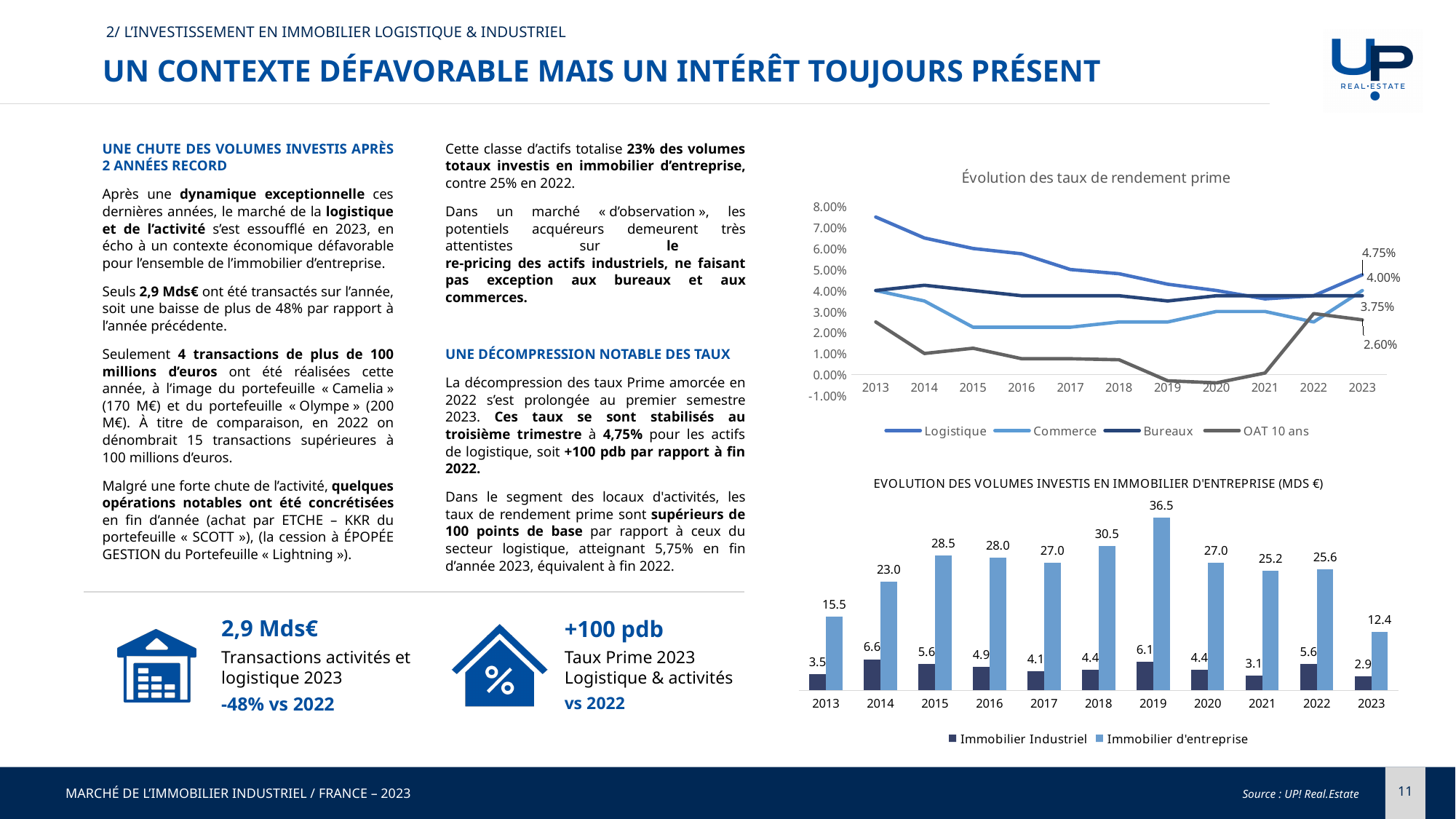
In the chart 'Évolution des taux de rendement prime', does the Logistique series rise or fall between 2013 and 2019? Fall In the bar chart 'Evolution des volumes investis en immobilier d'entreprise', what is the value for Immobilier Industriel in 2023? 2.9 In the chart 'Évolution des taux de rendement prime', is the value for Logistique in 2013 greater or less than 7.00%? greater In the chart 'Évolution des taux de rendement prime', what is the value for OAT 10 ans in 2023? 2.60% How many years are shown on the x axis of the bar chart 'Evolution des volumes investis en immobilier d'entreprise'? 11 In the bar chart 'Evolution des volumes investis en immobilier d'entreprise', what is the value for Immobilier d'entreprise in 2019? 36.5 In the bar chart 'Evolution des volumes investis en immobilier d'entreprise', which year has the lowest value for Immobilier Industriel? 2023 How many series does the legend of the chart 'Évolution des taux de rendement prime' list? 4 In the chart 'Évolution des taux de rendement prime', what is the value for Logistique in 2023? 4.75% In the bar chart 'Evolution des volumes investis en immobilier d'entreprise', which year has the highest value for Immobilier d'entreprise? 2019 What kind of chart is 'Évolution des taux de rendement prime'? Line chart In the bar chart 'Evolution des volumes investis en immobilier d'entreprise', what is the difference between the Immobilier Industriel values for 2022 and 2023? 2.7